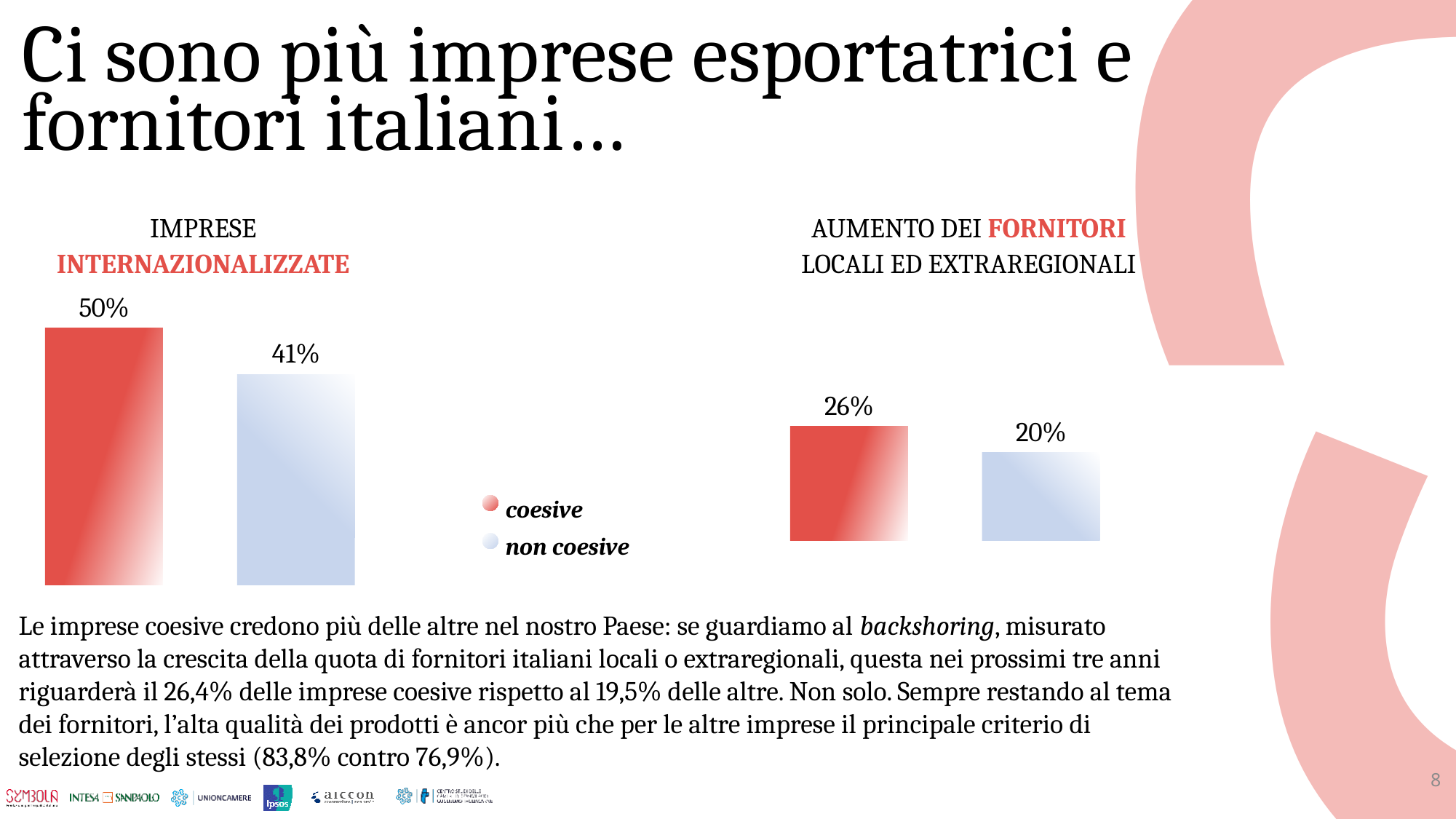
In the 'AUMENTO DEI FORNITORI LOCALI ED EXTRAREGIONALI' chart, which group has the lower value? non coesive In the 'AUMENTO DEI FORNITORI LOCALI ED EXTRAREGIONALI' chart, what is the value for non coesive? 20% In the 'IMPRESE INTERNAZIONALIZZATE' chart, what is the value for coesive? 50% In the 'IMPRESE INTERNAZIONALIZZATE' chart, what is the difference between the coesive and non coesive values? 9 percentage points What kind of chart is the 'IMPRESE INTERNAZIONALIZZATE' chart? Bar chart In the 'IMPRESE INTERNAZIONALIZZATE' chart, what is the value for non coesive? 41% In the 'AUMENTO DEI FORNITORI LOCALI ED EXTRAREGIONALI' chart, what is the difference between the coesive and non coesive values? 6 percentage points Which colour represents the 'coesive' series in the legend? Red How many bars are shown in the 'AUMENTO DEI FORNITORI LOCALI ED EXTRAREGIONALI' chart? 2 In the 'AUMENTO DEI FORNITORI LOCALI ED EXTRAREGIONALI' chart, what is the value for coesive? 26% How many series does the legend list? 2 In the 'IMPRESE INTERNAZIONALIZZATE' chart, which group has the higher value, coesive or non coesive? coesive